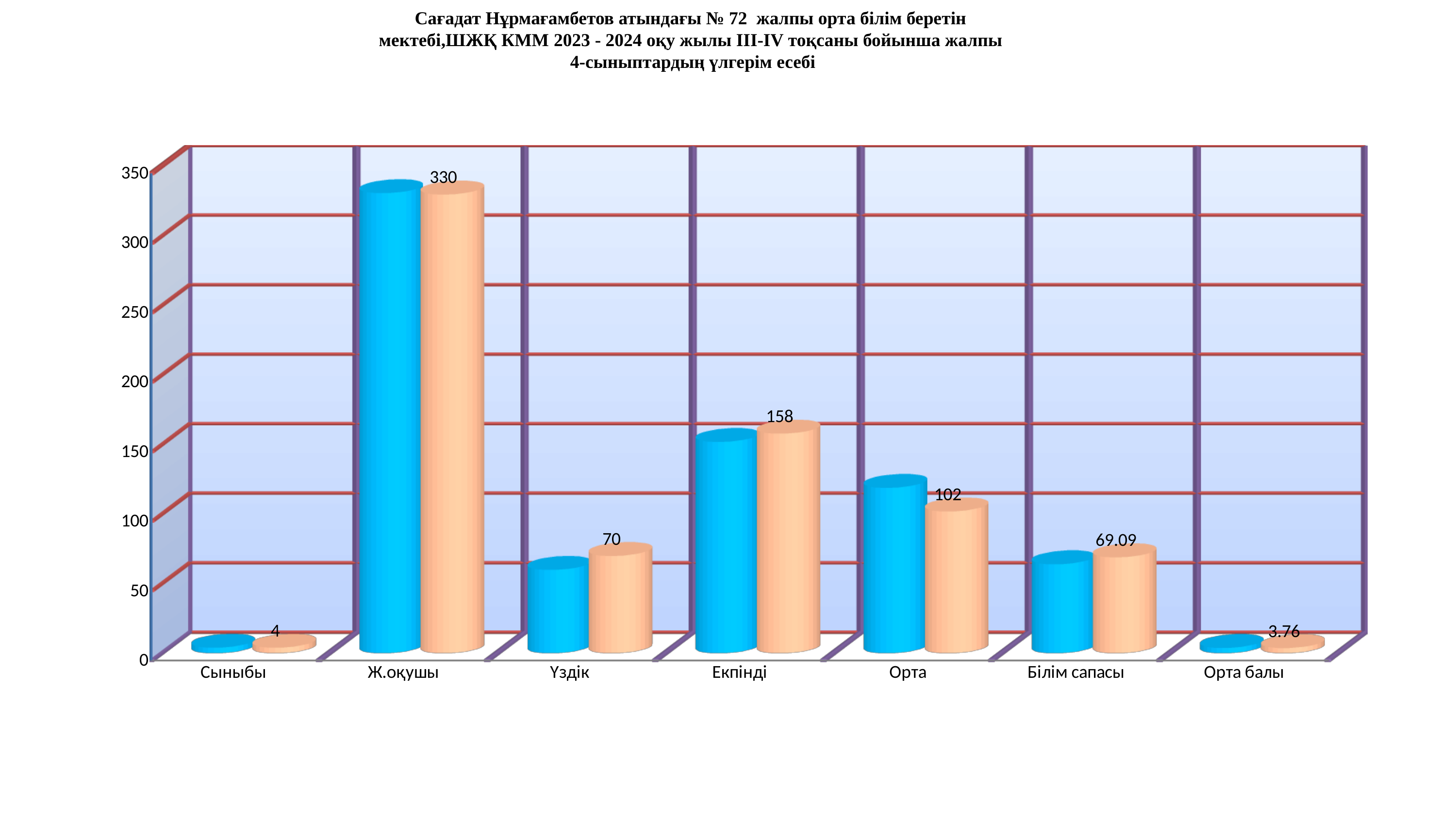
What value is labelled on the orange bar for Білім сапасы? 69.09 Which category has the highest labelled value on the orange bars? Ж.оқушы How many bars are shown for each category? 2 What value is labelled on the orange bar for Ж.оқушы? 330 Which has the larger labelled orange-bar value, Үздік or Орта? Орта What is the difference between the labelled orange-bar values for Екпінді and Орта? 56 How many categories are shown on the x axis? 7 Which category has the lowest labelled value on the orange bars? Орта балы What kind of chart is shown on the slide? bar chart Is the blue bar for Орта greater or less than 100? greater What value is labelled on the orange bar for Екпінді? 158 What value is labelled on the orange bar for Орта балы? 3.76